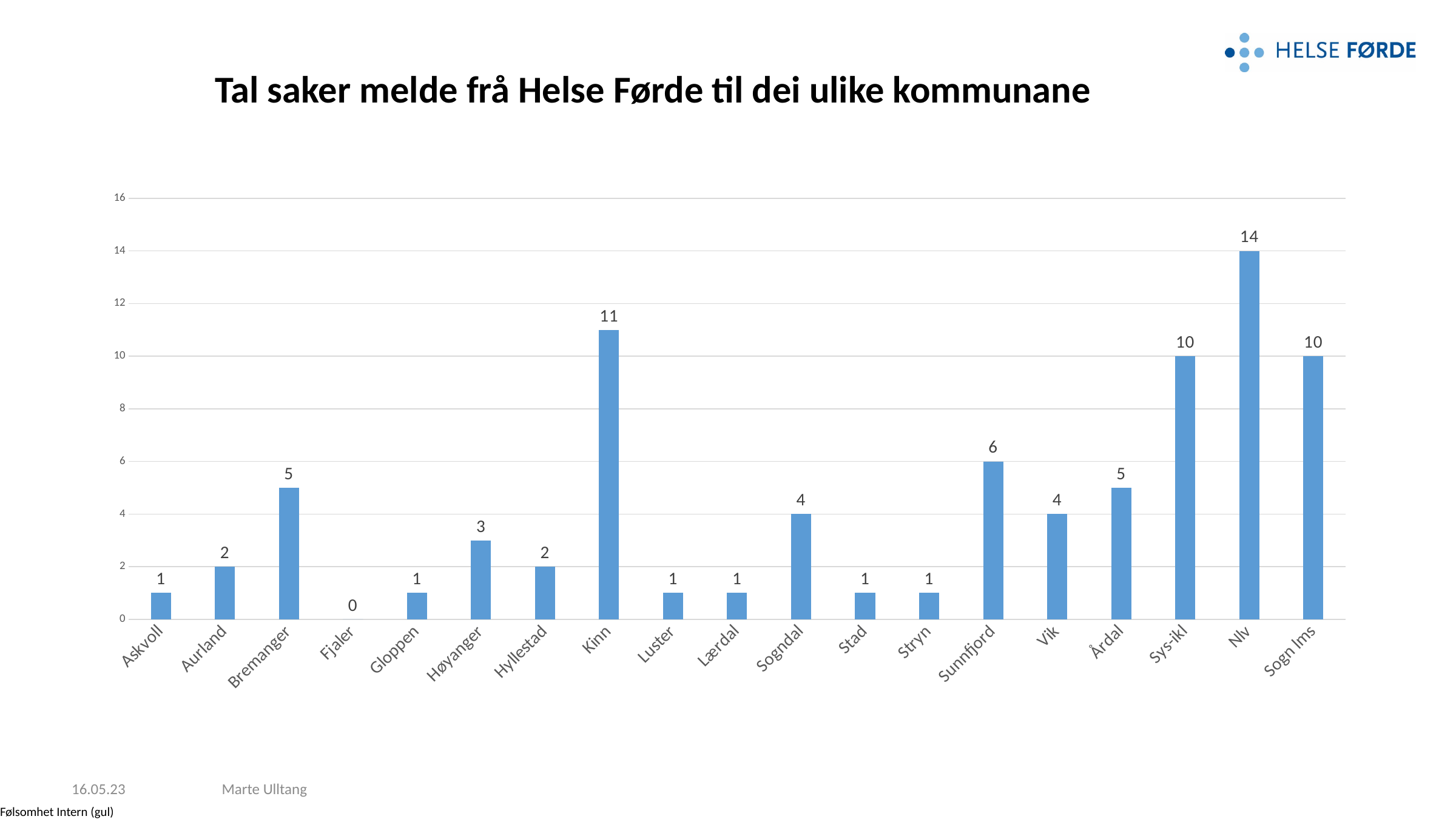
What is the value for Sunnfjord? 6 What is the value for Fjaler? 0 Which is larger, the value for Bremanger or the value for Sogndal? Bremanger Which category has the highest value? Nlv What is the difference between the values for Nlv and Kinn? 3 What is the title of the chart? Tal saker melde frå Helse Førde til dei ulike kommunane How many categories are shown on the x axis? 19 Is the value for Sys-ikl greater or less than 8? greater Which category has the lowest value? Fjaler What is the difference between the values for Sys-ikl and Sogn Ims? 0 What is the value for Kinn? 11 What kind of chart is this? bar chart